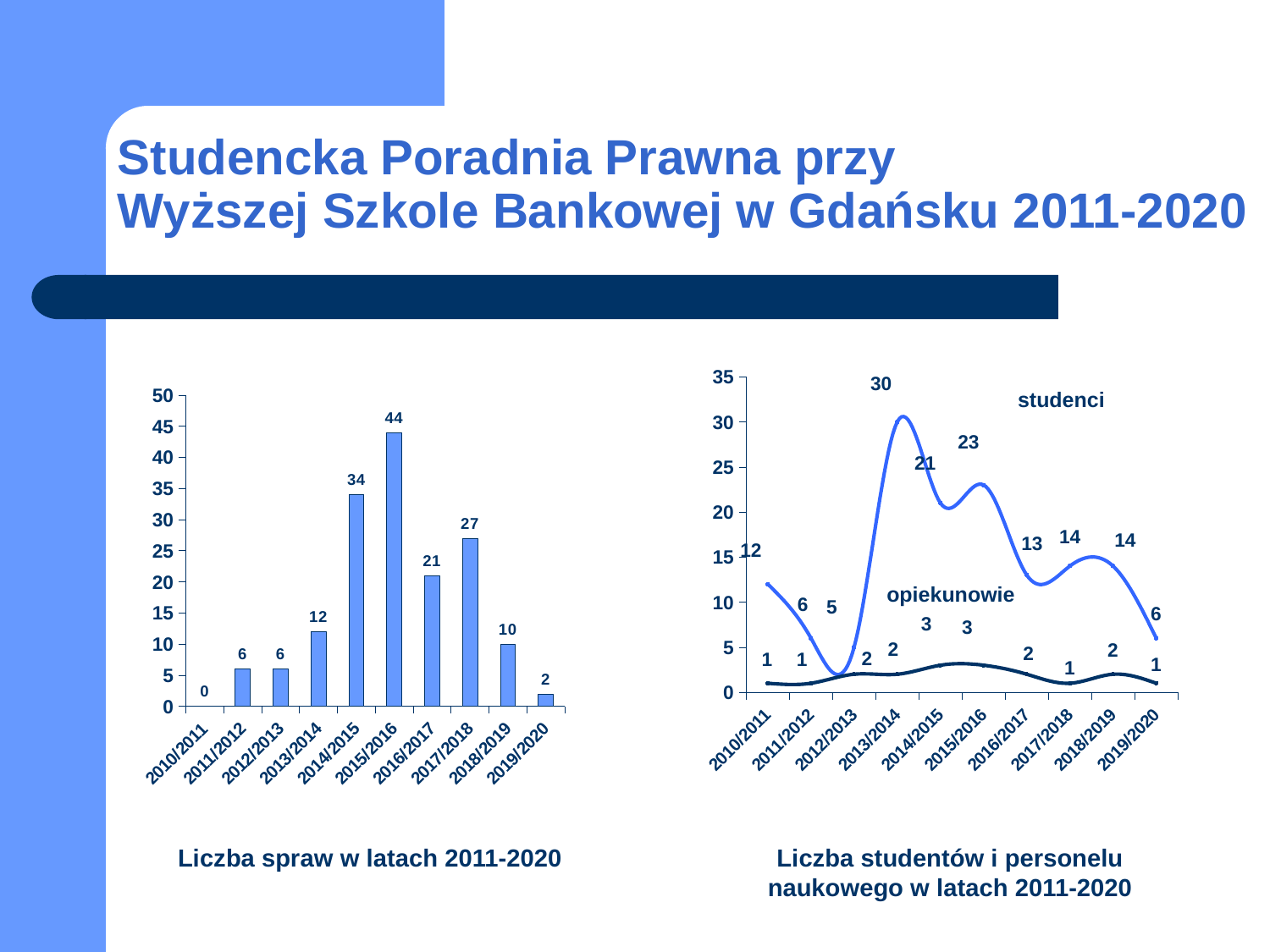
What kind of chart is the left chart (Liczba spraw w latach 2011-2020)? bar chart In the left chart (Liczba spraw w latach 2011-2020), which year has the highest value? 2015/2016 In the left chart (Liczba spraw w latach 2011-2020), which is larger, the value for 2016/2017 or 2017/2018? 2017/2018 In the right chart (Liczba studentów i personelu naukowego w latach 2011-2020), what is the value for studenci in 2013/2014? 30 In the left chart (Liczba spraw w latach 2011-2020), how many years are shown on the x axis? 10 In the right chart (Liczba studentów i personelu naukowego w latach 2011-2020), in which year is the studenci value highest? 2013/2014 In the right chart (Liczba studentów i personelu naukowego w latach 2011-2020), what is the value for opiekunowie in 2014/2015? 3 In the left chart (Liczba spraw w latach 2011-2020), what is the value for 2015/2016? 44 In the right chart (Liczba studentów i personelu naukowego w latach 2011-2020), what is the difference between studenci and opiekunowie in 2015/2016? 20 What kind of chart is the right chart (Liczba studentów i personelu naukowego w latach 2011-2020)? line chart In the left chart (Liczba spraw w latach 2011-2020), which year has the lowest value? 2010/2011 In the left chart (Liczba spraw w latach 2011-2020), what is the difference between the values for 2015/2016 and 2014/2015? 10